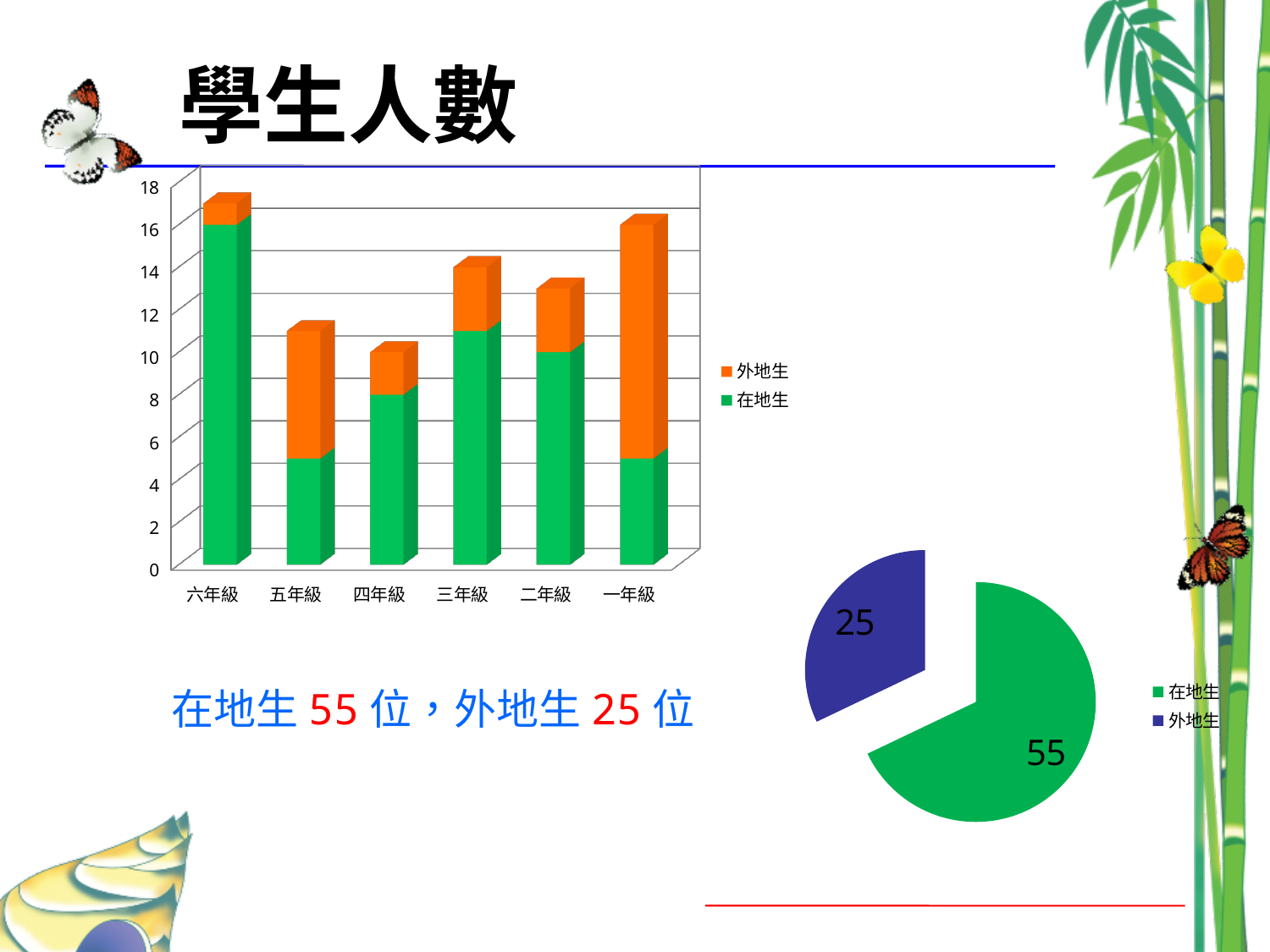
On the bar chart, is the total height of the 四年級 bar greater or less than 12? less On the bar chart, how many grade categories are shown on the x axis? 6 On the pie chart, what is the difference between the 在地生 and 外地生 values? 30 On the bar chart, is the 在地生 value for 一年級 greater or less than 8? less On the pie chart, what is the value for 外地生? 25 On the pie chart, what is the value for 在地生? 55 On the bar chart, which grade has the lowest value for 外地生? 六年級 What kind of chart is the chart on the left of the slide? bar chart On the bar chart, which grade has the highest value for 外地生? 一年級 On the bar chart, how many series does the legend list? 2 What kind of chart is the chart on the right of the slide? pie chart On the bar chart, which grade has the highest value for 在地生? 六年級